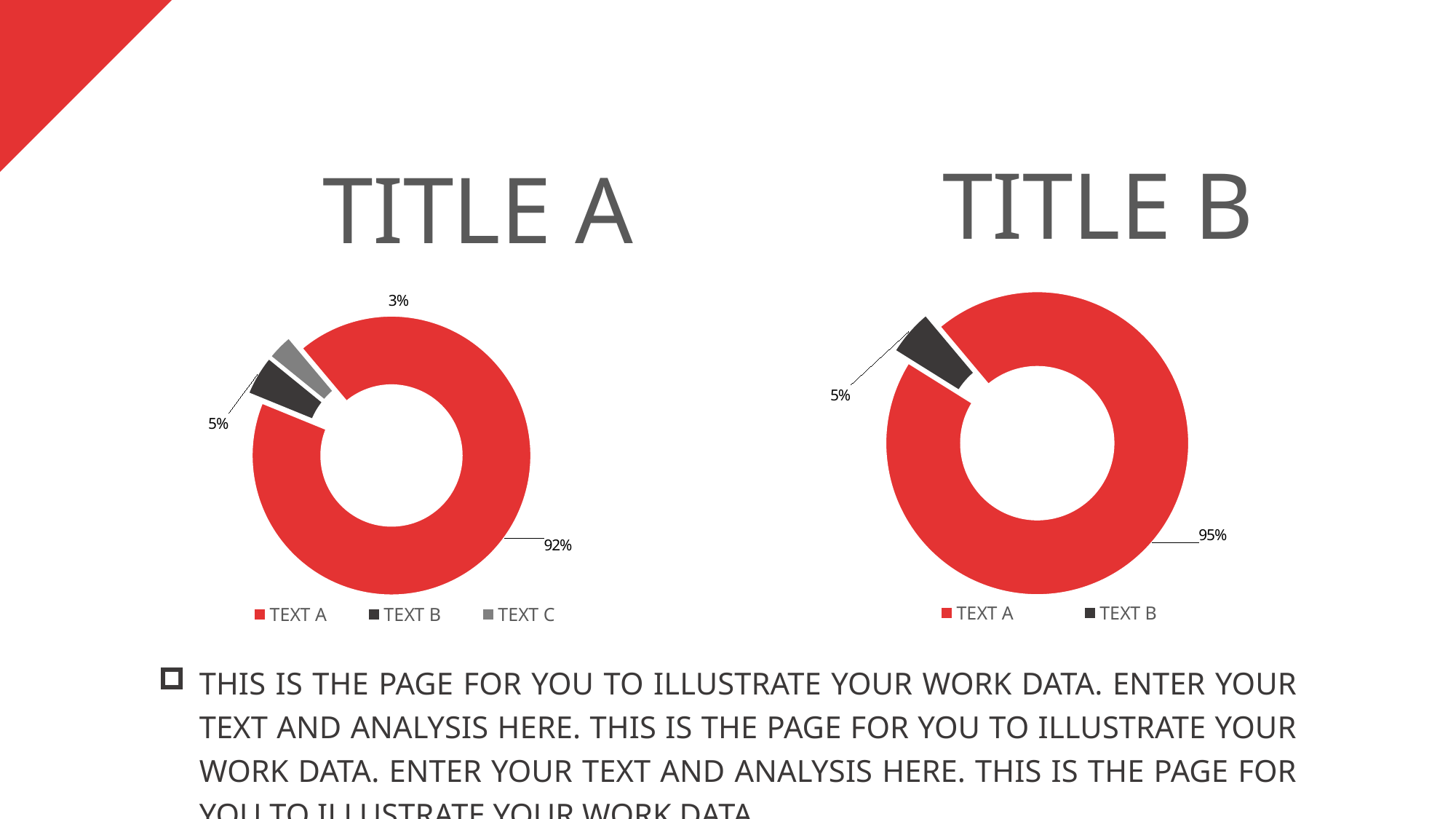
In the TITLE A chart, which category has the smallest share? TEXT C In the TITLE A chart, what percentage is shown for TEXT A? 92% In the TITLE B chart, which category has the smallest share? TEXT B In the TITLE B chart, what percentage is shown for TEXT B? 5% In the TITLE A chart, which category has the largest share? TEXT A In the TITLE A chart, what percentage is shown for TEXT B? 5% In the TITLE B chart, what percentage is shown for TEXT A? 95% How many categories does the legend of the TITLE B chart list? 2 How many categories does the legend of the TITLE A chart list? 3 In the TITLE A chart, what percentage is shown for TEXT C? 3% In the TITLE A chart, what is the difference between the TEXT B and TEXT C percentages? 2% What kind of chart is the TITLE B chart? Doughnut (pie) chart